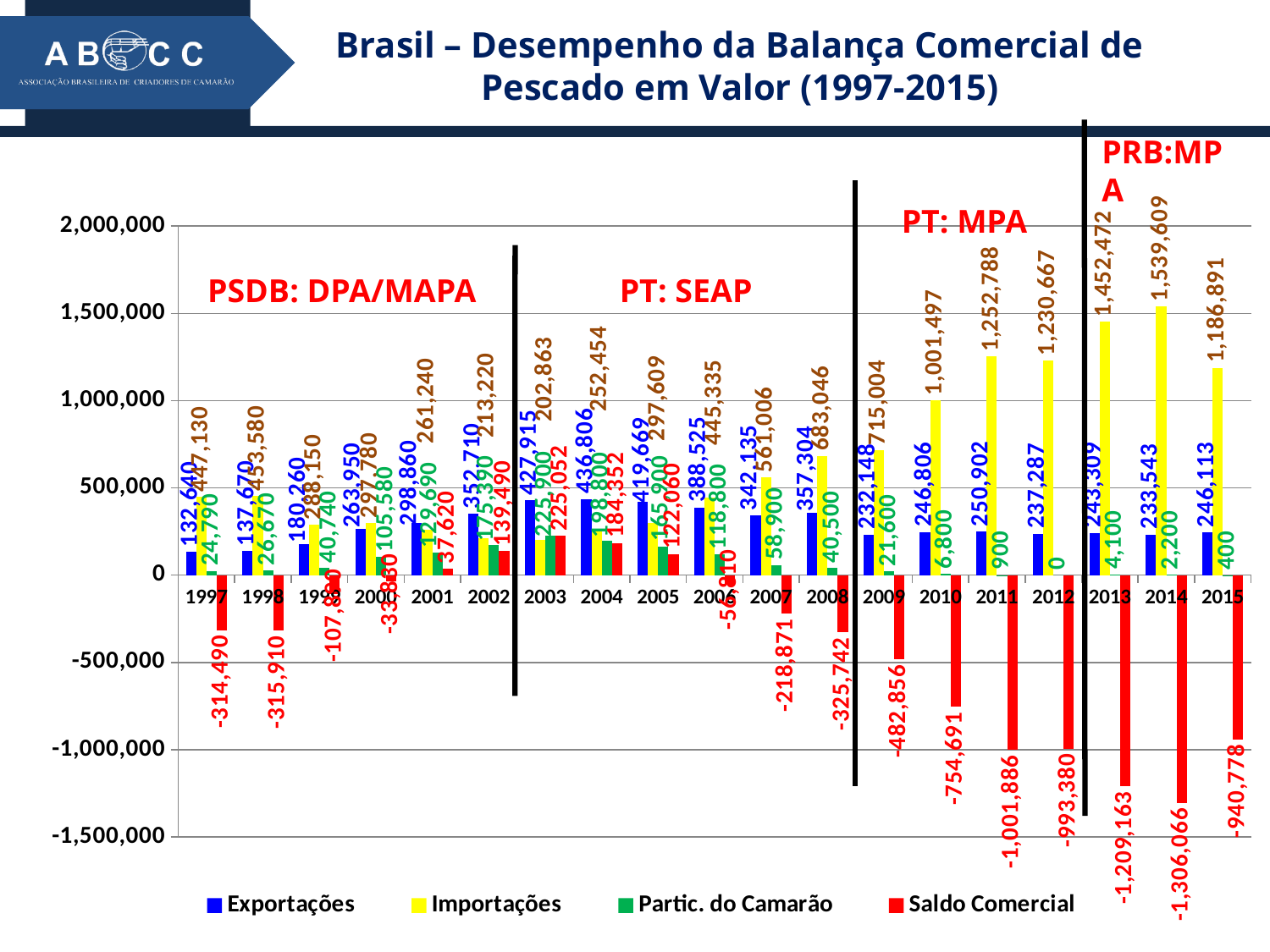
What is the value of Exportações in 2004? 436,806 What is the Saldo Comercial in 2013? -1,209,163 Which is larger in 2009: Exportações or Importações? Importações In which year is Importações highest? 2014 In which year is Saldo Comercial lowest? 2014 How many series does the legend list? 4 How many years are shown on the x axis? 19 What is the difference between Importações in 2014 and in 2013? 87,137 What is the value of Partic. do Camarão in 2003? 225,900 Which series is shown in yellow in the legend? Importações What type of chart is shown on the slide? bar chart What is the value of Importações in 2014? 1,539,609